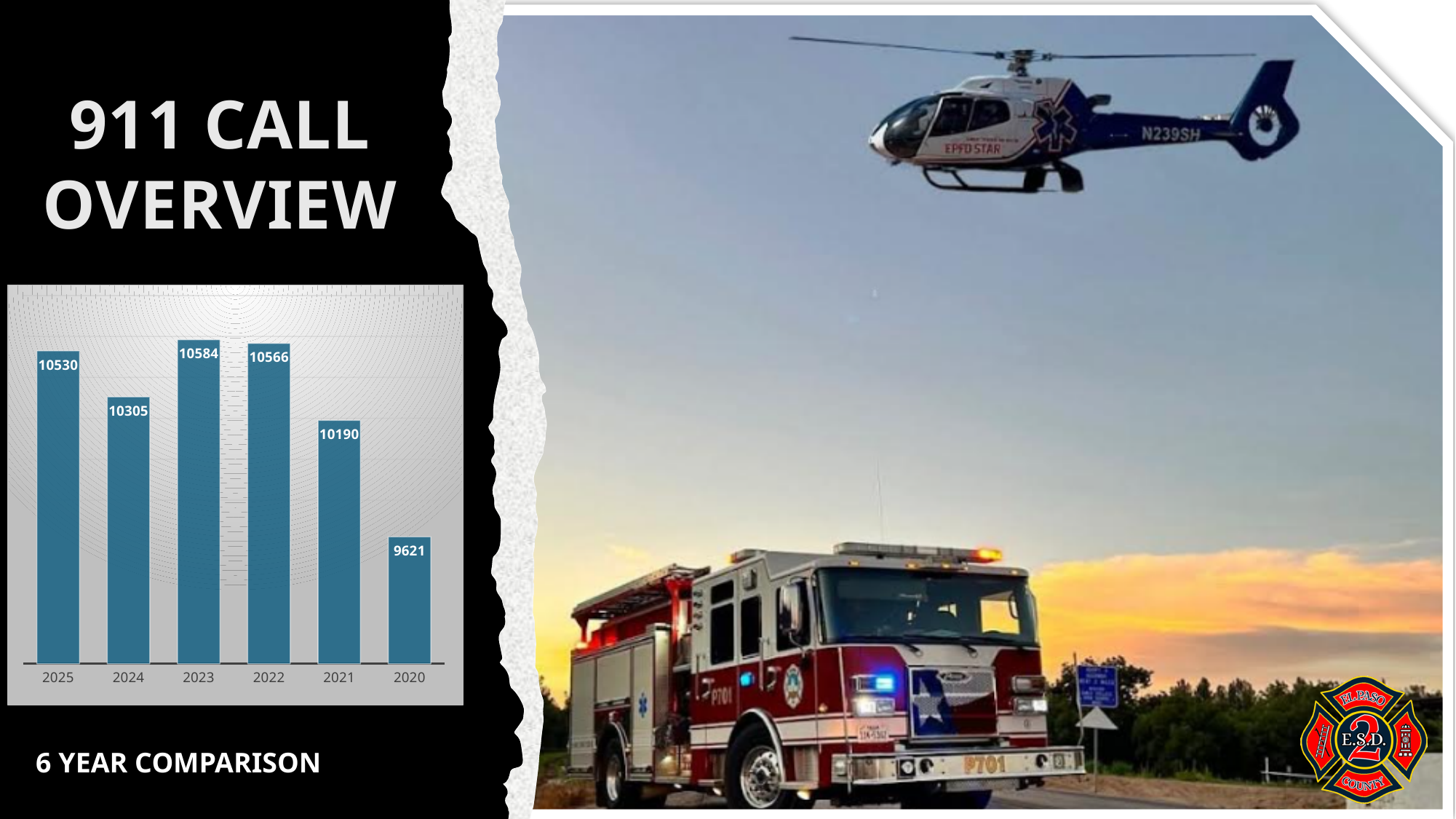
What is the value shown for 2021? 10190 What is the value shown for 2020? 9621 What is the title of the slide containing the chart? 911 CALL OVERVIEW What is the difference between the values for 2025 and 2024? 225 How many years are shown in the chart? 6 What is the difference between the values for 2023 and 2020? 963 What kind of chart is shown on the slide? bar chart What is the value shown for 2025? 10530 Which is larger, the value for 2021 or the value for 2020? 2021 Which year has the highest value? 2023 Which year has the lowest value? 2020 Which is larger, the value for 2025 or the value for 2024? 2025